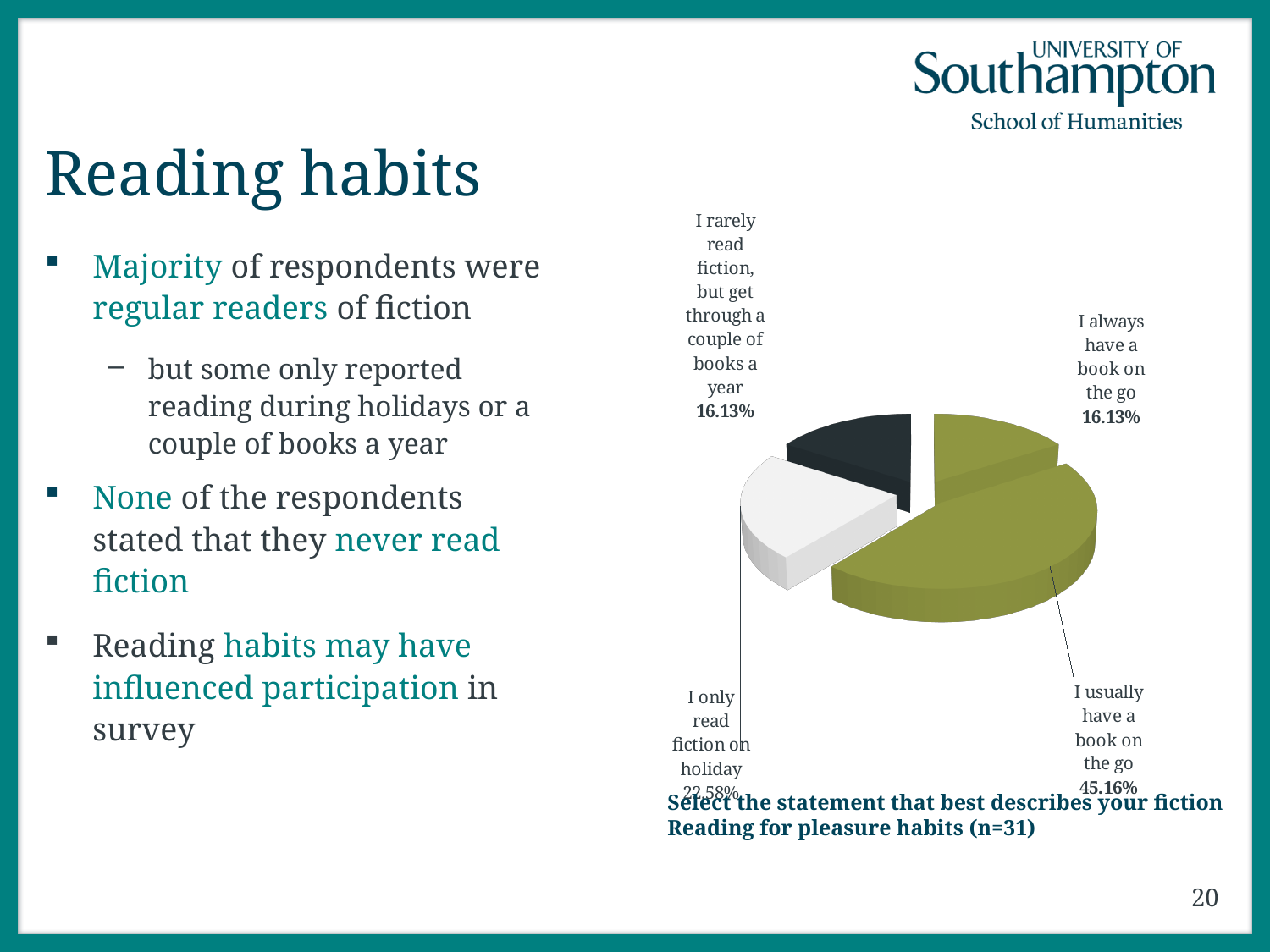
What percentage of respondents said "I only read fiction on holiday"? 22.58% Which statement was chosen by the largest share of respondents? I usually have a book on the go How many slices does the pie chart have? 4 Which is larger: the share for "I only read fiction on holiday" or the share for "I always have a book on the go"? I only read fiction on holiday What is the difference between the share for "I usually have a book on the go" and the share for "I always have a book on the go"? 29.03% What percentage of respondents said "I always have a book on the go"? 16.13% What percentage of respondents said "I usually have a book on the go"? 45.16% What percentage of respondents said they rarely read fiction but get through a couple of books a year? 16.13% What kind of chart is shown on the slide? pie chart Which two statements have the same share of respondents? I always have a book on the go; I rarely read fiction, but get through a couple of books a year What is the difference between the share for "I usually have a book on the go" and the share for "I only read fiction on holiday"? 22.58% How many respondents (n) does the chart caption say took part? 31